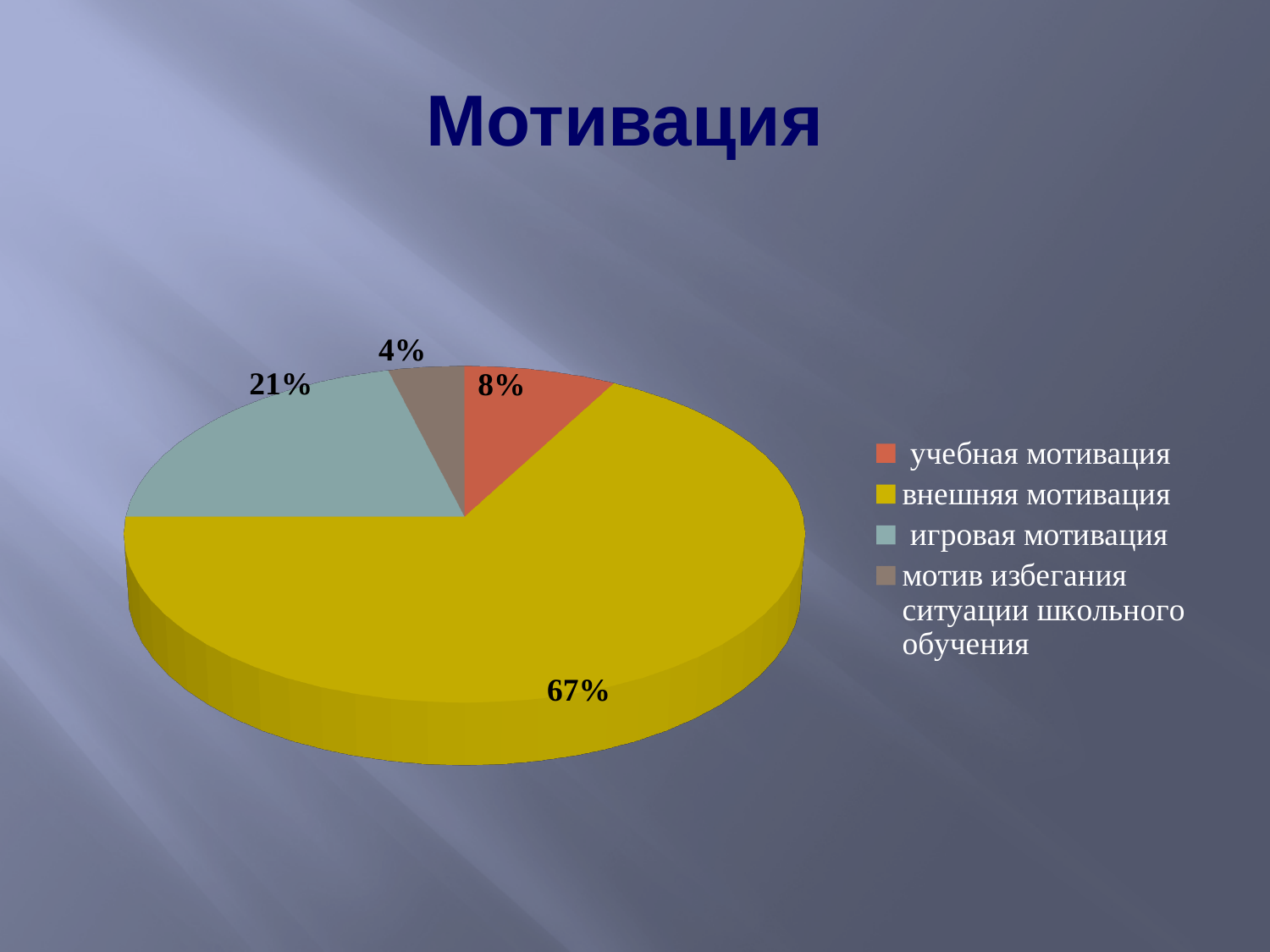
What is the value for учебная мотивация? 8% Which category has the smallest share of the pie? мотив избегания ситуации школьного обучения What is the title of the slide? Мотивация What is the difference between the values for внешняя мотивация and игровая мотивация? 46% What kind of chart is shown on the slide? pie chart What is the value for игровая мотивация? 21% What is the value for мотив избегания ситуации школьного обучения? 4% What colour is the slice for внешняя мотивация? yellow Which category has the largest share of the pie? внешняя мотивация How many categories does the pie chart have? 4 Which is larger, the value for игровая мотивация or the value for учебная мотивация? игровая мотивация What is the value for внешняя мотивация? 67%